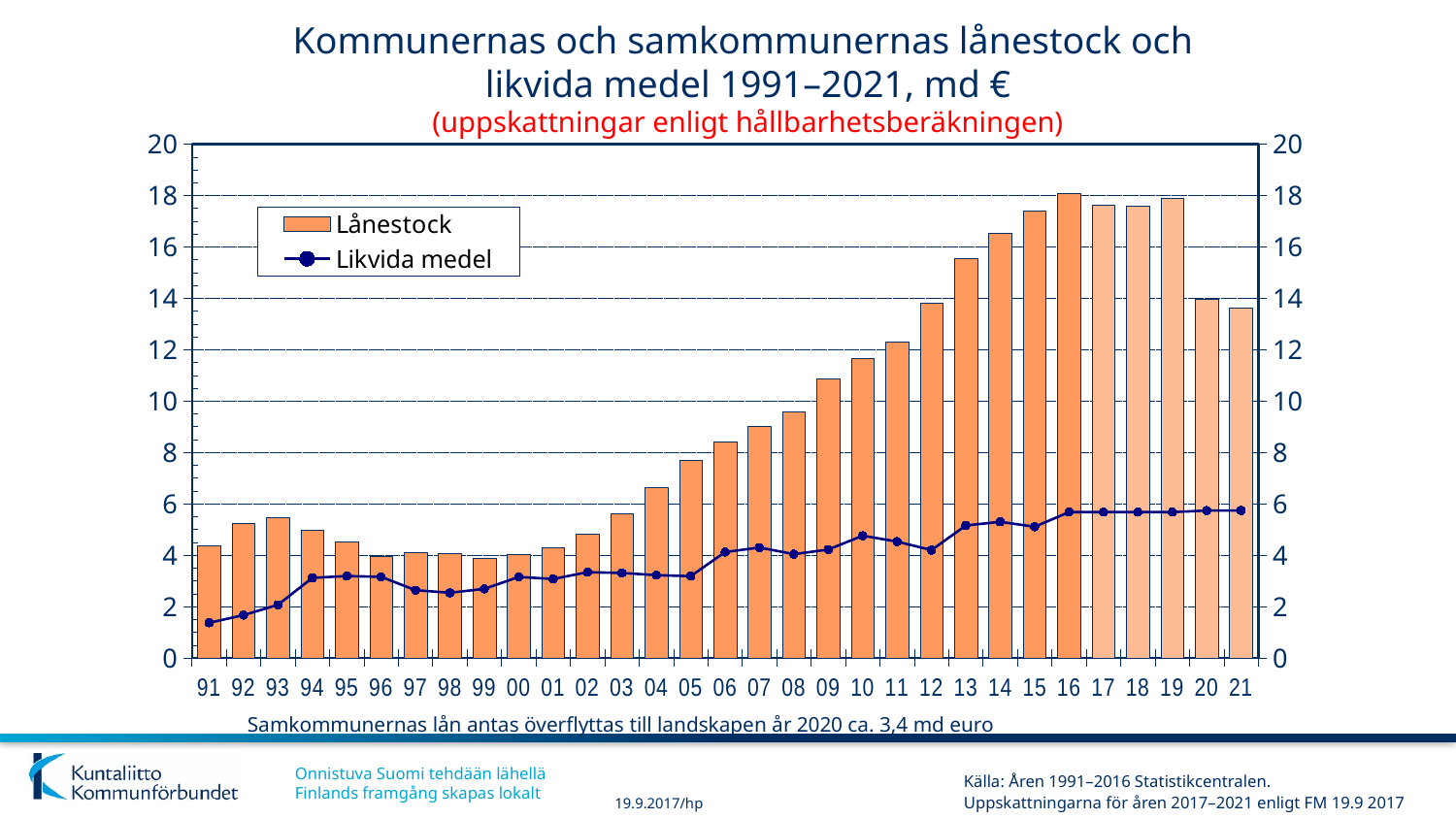
Which is larger, the Likvida medel value for 2010 or for 2012? 2010 Is the Likvida medel value for 1991 greater or less than 2? less Which year has the lowest Likvida medel value? 91 Is the Lånestock value for 2013 greater or less than 14? greater Is the Lånestock value for 2021 greater or less than 14? less Which two series are listed in the legend? Lånestock and Likvida medel Which is larger, the Lånestock value for 2011 or for 2012? 2012 What kind of chart is shown on the slide? A combined bar and line chart How many series does the legend list? 2 How many years are shown on the x axis? 31 Does the Lånestock series rise or fall from 2005 to 2016? rise